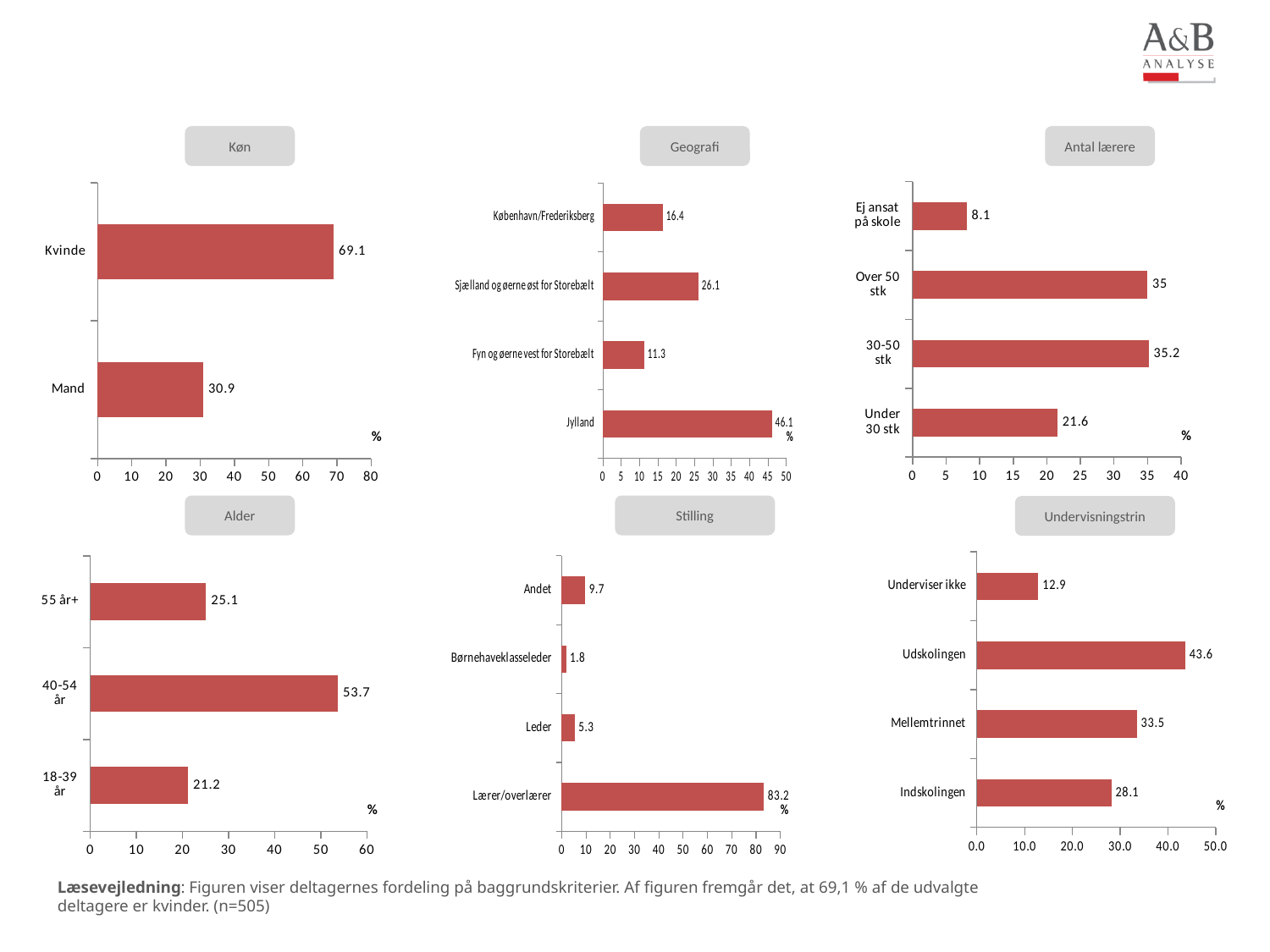
In the Antal lærere chart, what is the value for Under 30 stk? 21.6 In the Undervisningstrin chart, which is larger, Udskolingen or Mellemtrinnet? Udskolingen In the Køn chart, what is the difference between the values for Kvinde and Mand? 38.2 In the Stilling chart, which category has the lowest value? Børnehaveklasseleder What kind of chart is the Køn chart? Bar chart In the Antal lærere chart, which category has the lowest value? Ej ansat på skole In the Køn chart, what is the value for Kvinde? 69.1 In the Geografi chart, what is the value for Fyn og øerne vest for Storebælt? 11.3 In the Stilling chart, what is the value for Lærer/overlærer? 83.2 In the Alder chart, what is the difference between the values for 40-54 år and 18-39 år? 32.5 In the Undervisningstrin chart, how many categories are shown? 4 In the Geografi chart, which category has the highest value? Jylland